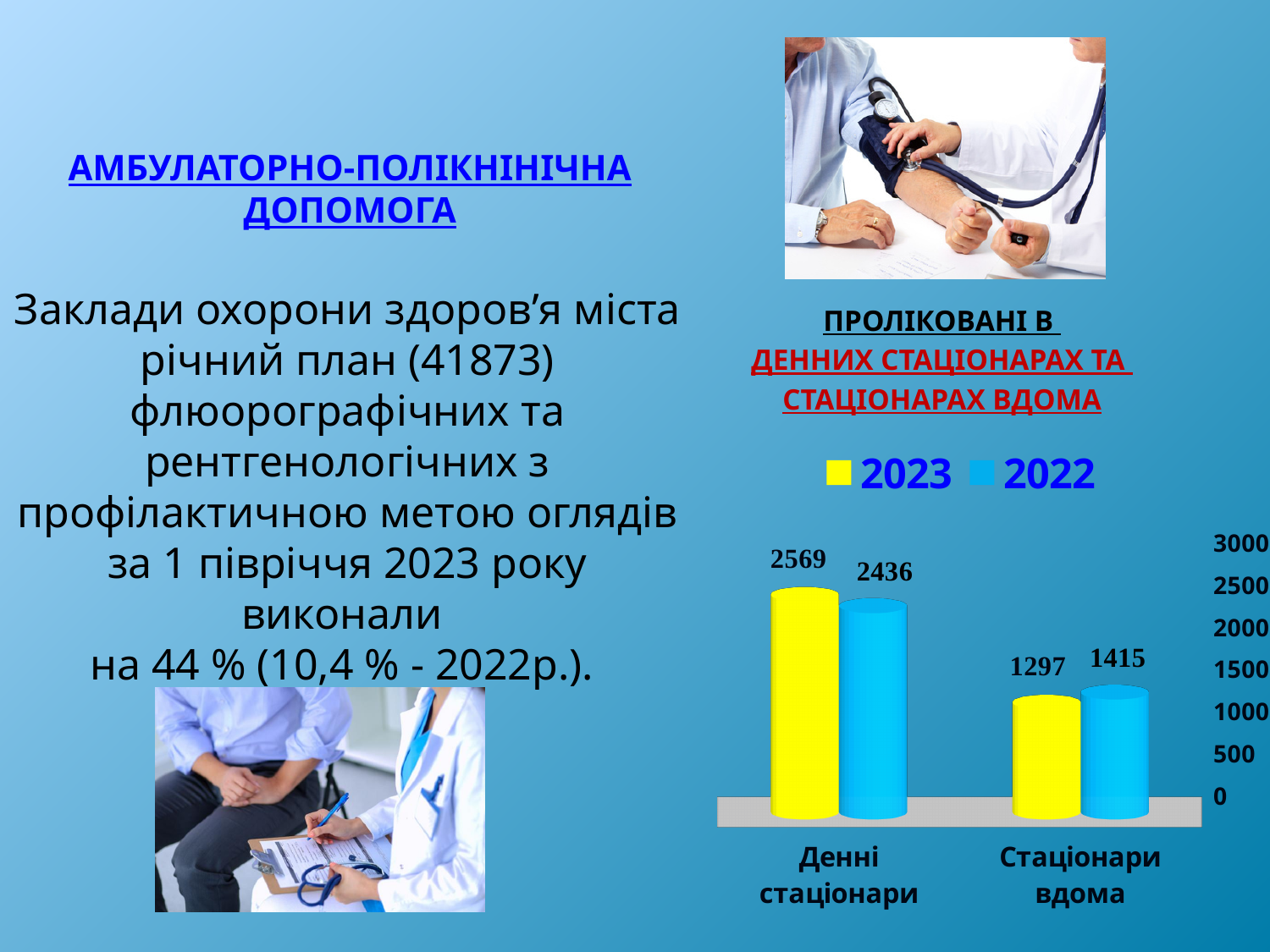
Which is larger for Стаціонари вдома, the 2023 value or the 2022 value? 2022 What is the difference between the 2023 and 2022 values for Денні стаціонари? 133 Which category has the lowest value for 2022? Стаціонари вдома How many categories are shown on the x axis of the chart? 2 What is the value for 2022 in the Стаціонари вдома category? 1415 What is the value for 2023 in the Денні стаціонари category? 2569 What is the value for 2022 in the Денні стаціонари category? 2436 What kind of chart is shown on the slide? Bar chart How many series does the chart legend list? 2 What is the value for 2023 in the Стаціонари вдома category? 1297 Which category has the highest value for 2023? Денні стаціонари What is the difference between the 2022 and 2023 values for Стаціонари вдома? 118